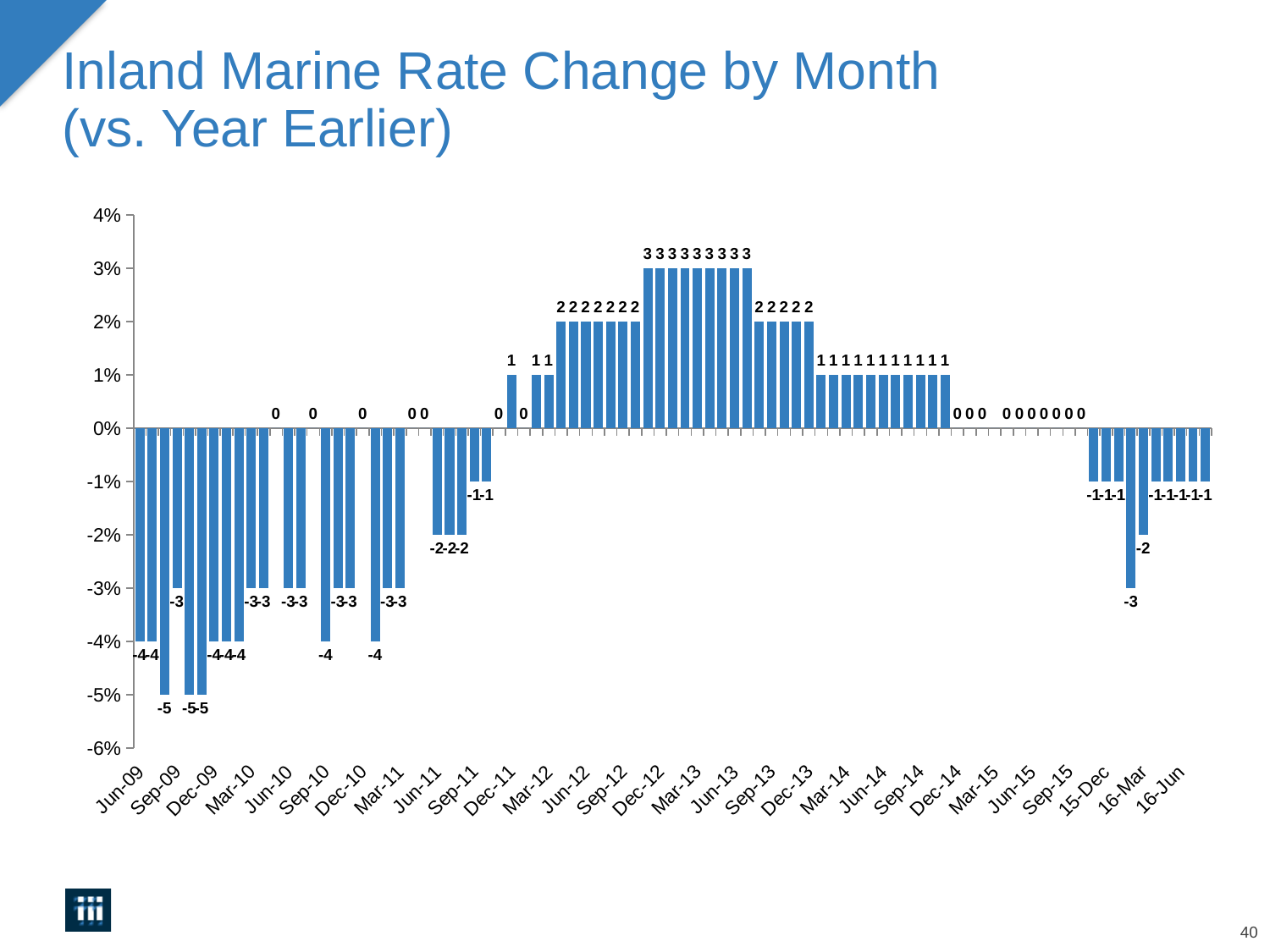
Which is larger, the value for Jun-09 or the value for 16-Jun? 16-Jun What is the highest value shown on the vertical axis? 4% What is the data label on the first bar (Jun-09)? -4 What is the difference between the highest data label (3) and the lowest data label (-5)? 8 How many consecutive bars carry the data label 3? 9 What is the highest data label value shown in the chart? 3 What kind of chart is shown on the slide? bar chart Is the value for Jun-09 greater or less than -3%? less What is the lowest data label value shown in the chart? -5 What is the data label on the last bar (16-Jun)? -1 What is the title of the chart? Inland Marine Rate Change by Month (vs. Year Earlier) Do the values generally rise or fall from Jun-09 through Dec-12? rise